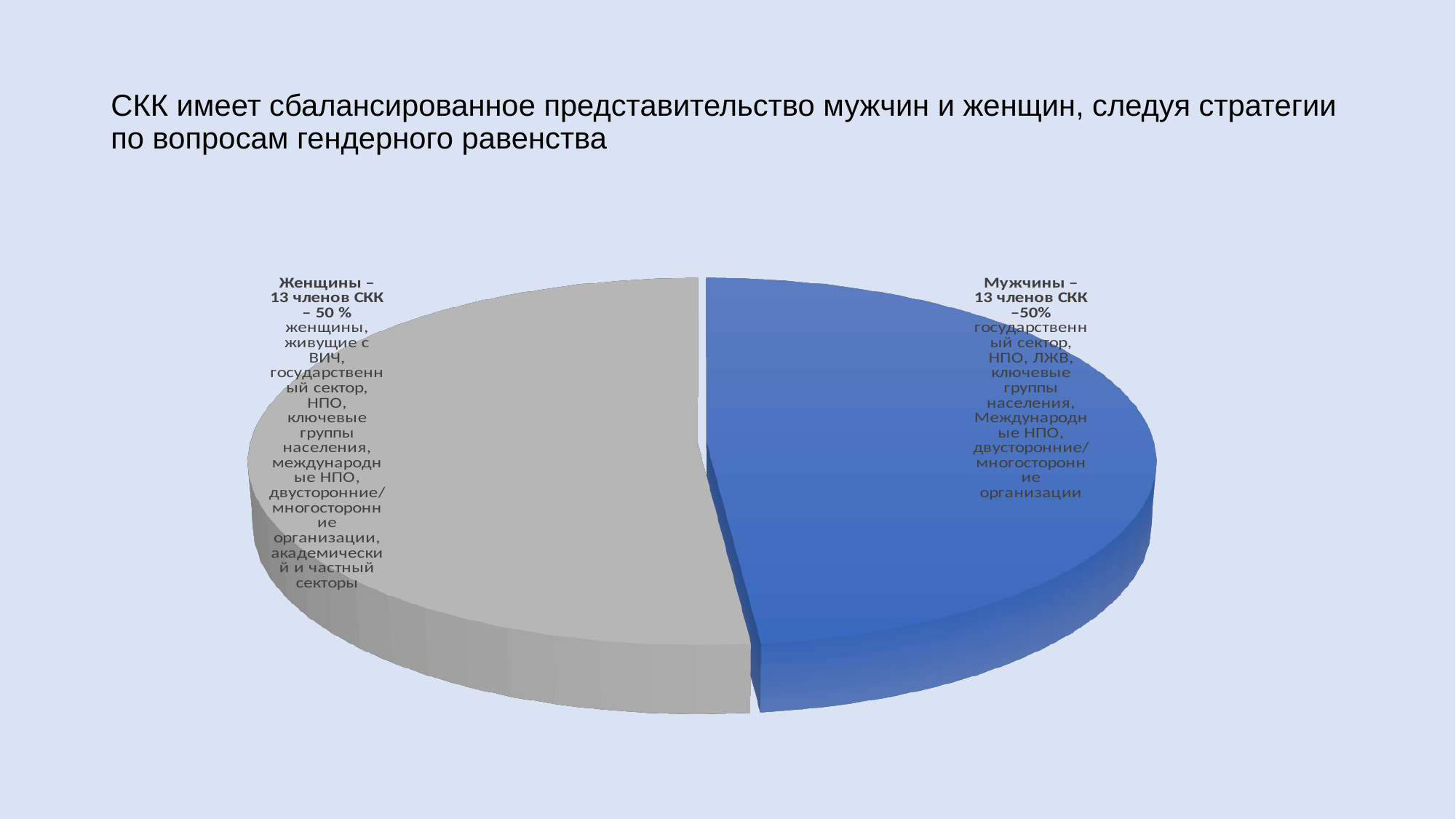
How many members of СКК are women (Женщины) according to the chart? 13 What is the total number of СКК members represented by the two slices of the pie chart? 26 What kind of chart is shown on the slide? pie chart Which colour is the Женщины slice of the pie chart? gray What is the difference between the number of women and the number of men among СКК members shown in the chart? 0 What share of the pie does the Мужчины slice represent? 50% What share of the pie does the Женщины slice represent? 50 % How many slices does the pie chart have? 2 How many members of СКК are men (Мужчины) according to the chart? 13 Which colour is the Мужчины slice of the pie chart? blue